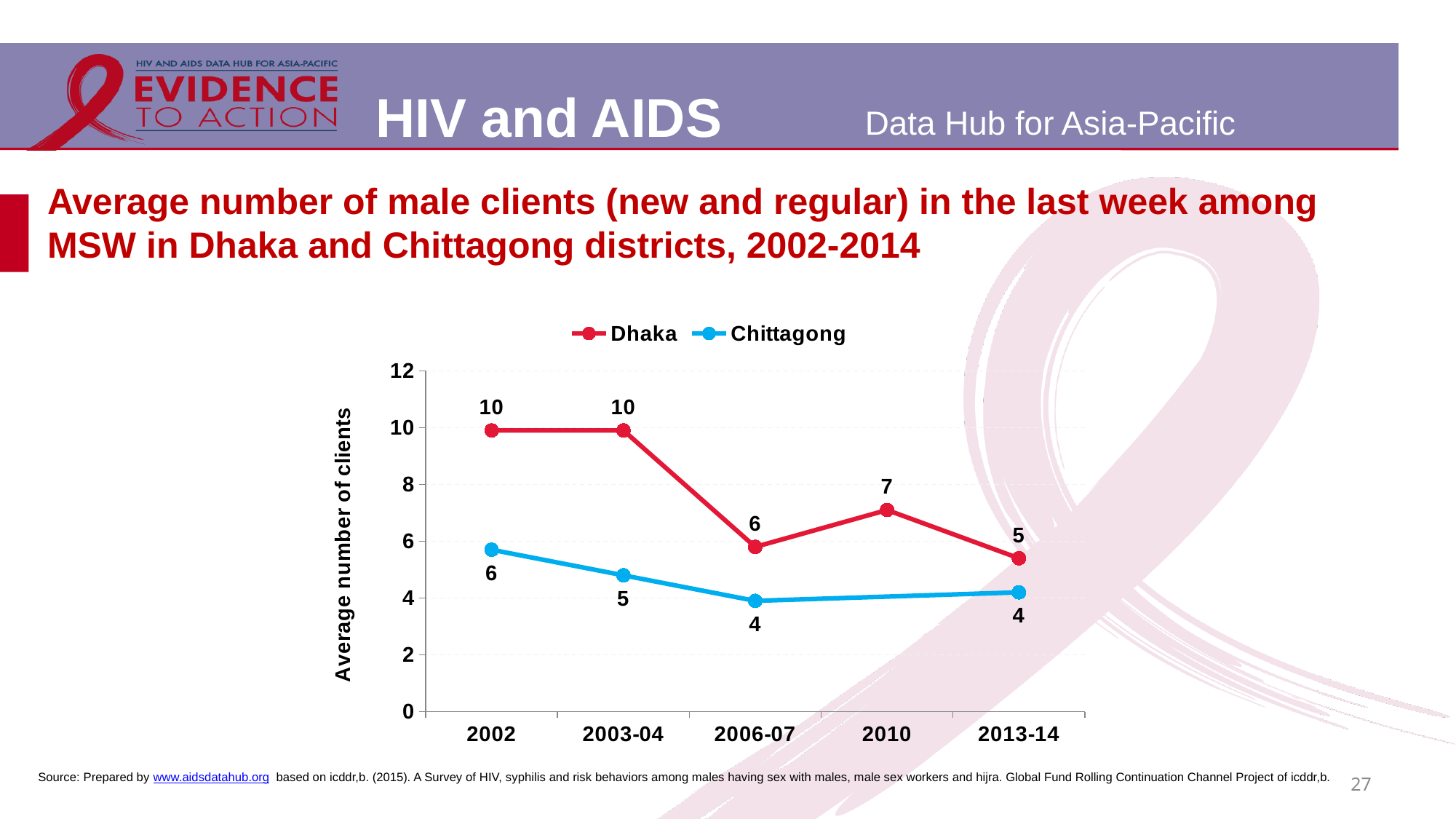
Does the Dhaka series overall rise or fall from 2002 to 2013-14? Fall What kind of chart is shown on the slide? Line chart How many time periods are shown on the x axis? 5 How many series does the legend list? 2 What is the difference between the Dhaka and Chittagong values in 2002? 4 In which period is the Dhaka value lowest? 2013-14 Which series has the larger value in 2003-04, Dhaka or Chittagong? Dhaka What is the value for Dhaka in 2010? 7 What colour is the line for Chittagong? Blue What is the value for Dhaka in 2002? 10 What is the value for Chittagong in 2006-07? 4 What is the value for Chittagong in 2013-14? 4